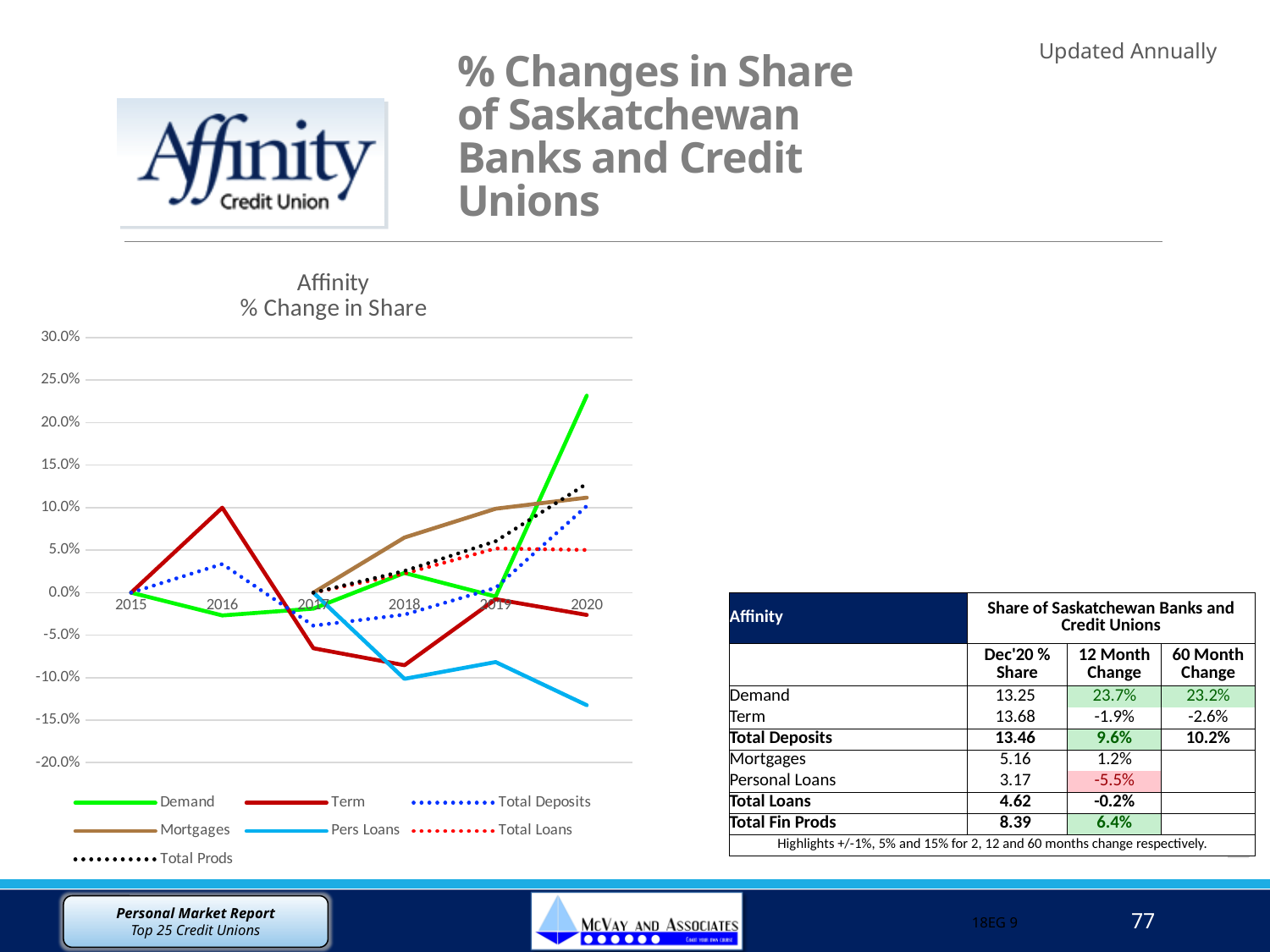
In which year does the Term series reach its highest value? 2016 Which series has the highest value in 2020? Demand Is the value for Demand in 2020 greater or less than 20.0%? greater Do the values for Mortgages rise or fall from 2017 to 2020? rise How many series does the chart legend list? 7 Is the value for Term in 2016 greater or less than 5.0%? greater Which series has the lowest value in 2020? Pers Loans How many years are plotted along the x axis of the chart? 6 Is the value for Pers Loans in 2020 greater or less than -10.0%? less In 2020, which is larger: the value for Demand or the value for Term? Demand What is the title of the chart? Affinity % Change in Share What kind of chart is shown on the slide? line chart